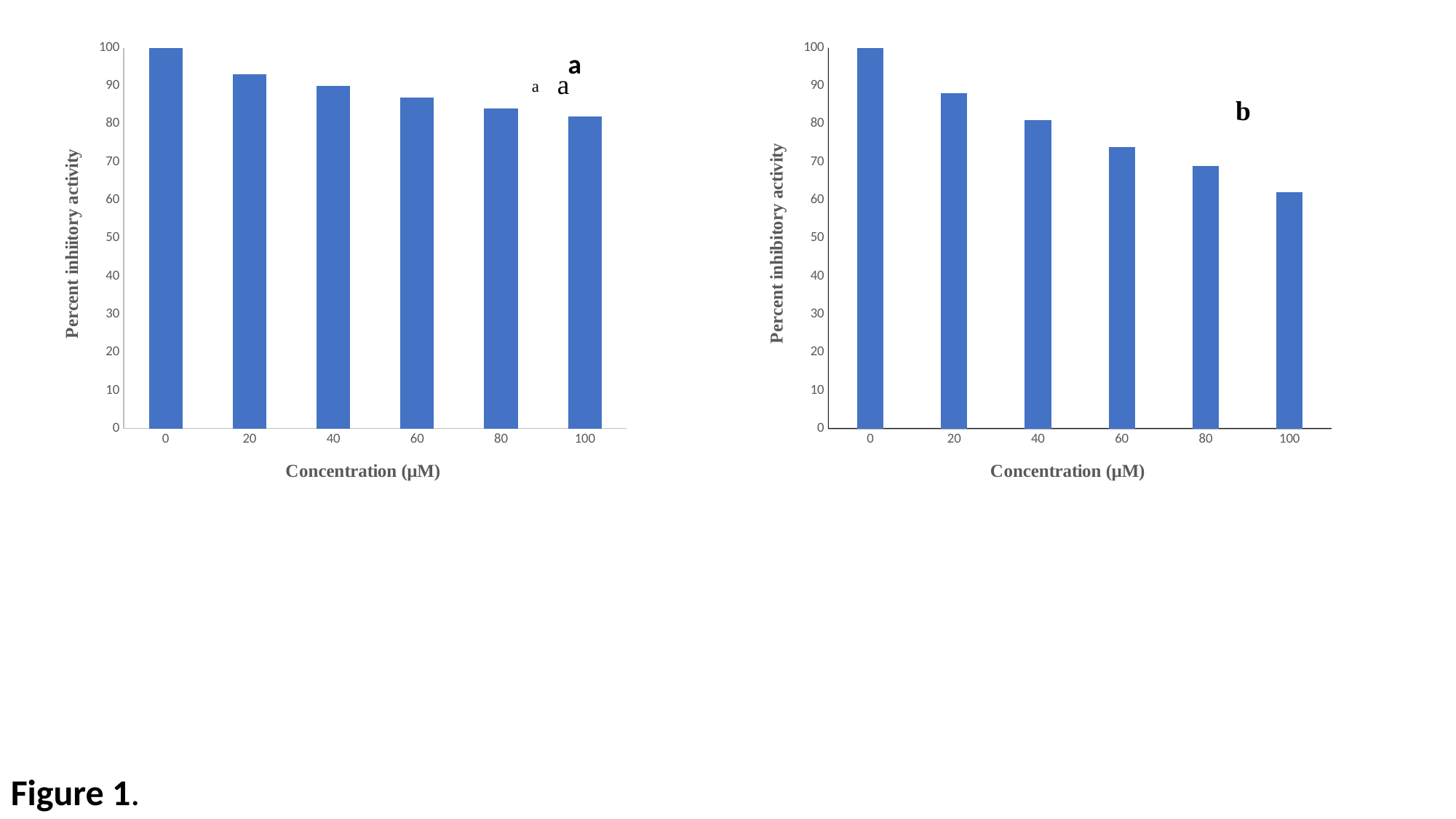
How many bars are plotted in the right chart (b)? 6 In the left chart (a), is the value at 20 µM greater or less than 90? greater In the right chart (b), do the values rise or fall as concentration increases along the x axis? fall In the right chart (b), is the value at 100 µM greater or less than 70? less What is the x-axis label of the right chart (b)? Concentration (µM) In the left chart (a), is the value at 100 µM greater or less than 90? less In the left chart (a), which concentration has the highest percent inhibitory activity? 0 What type of chart is the left chart (a)? bar chart In the right chart (b), which concentration has the lowest percent inhibitory activity? 100 Which is larger: the value at 100 µM in the left chart (a) or the value at 100 µM in the right chart (b)? left chart (a) In the left chart (a), what is the percent inhibitory activity at concentration 0 µM? 100